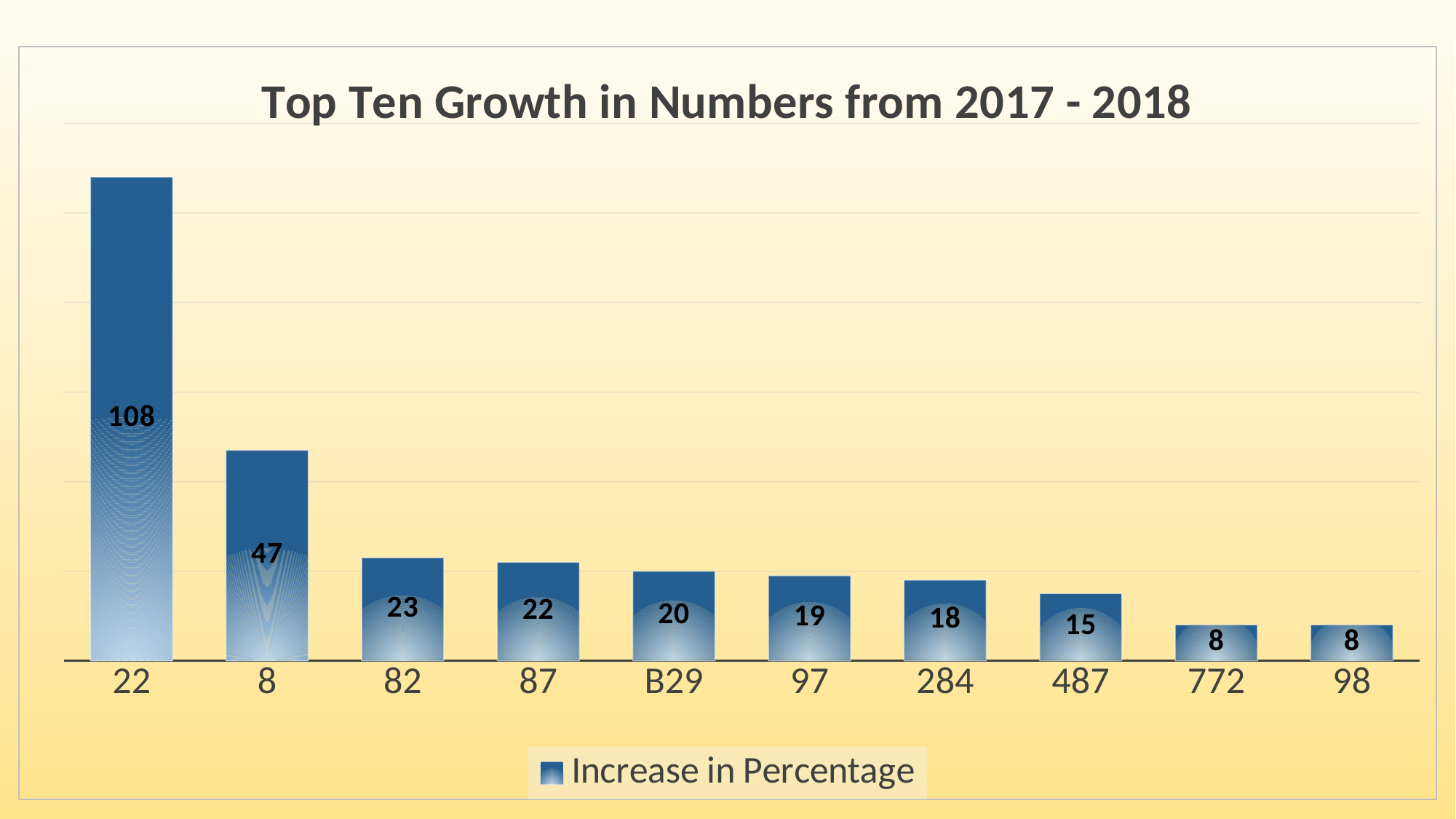
Which has a larger value, the category labelled "8" or the category labelled "97"? 8 How many categories are shown on the x axis? 10 What kind of chart is shown? Bar chart What is the value for the category labelled "487"? 15 What is the value for the category labelled "22"? 108 How many series does the legend list? 1 Do the values rise or fall from left to right along the x axis? Fall Which category has the highest value? 22 What is the difference between the values for the categories labelled "22" and "8"? 61 What is the difference between the values for the categories labelled "82" and "284"? 5 What is the value for the category labelled "B29"? 20 What is the title of the chart? Top Ten Growth in Numbers from 2017 - 2018